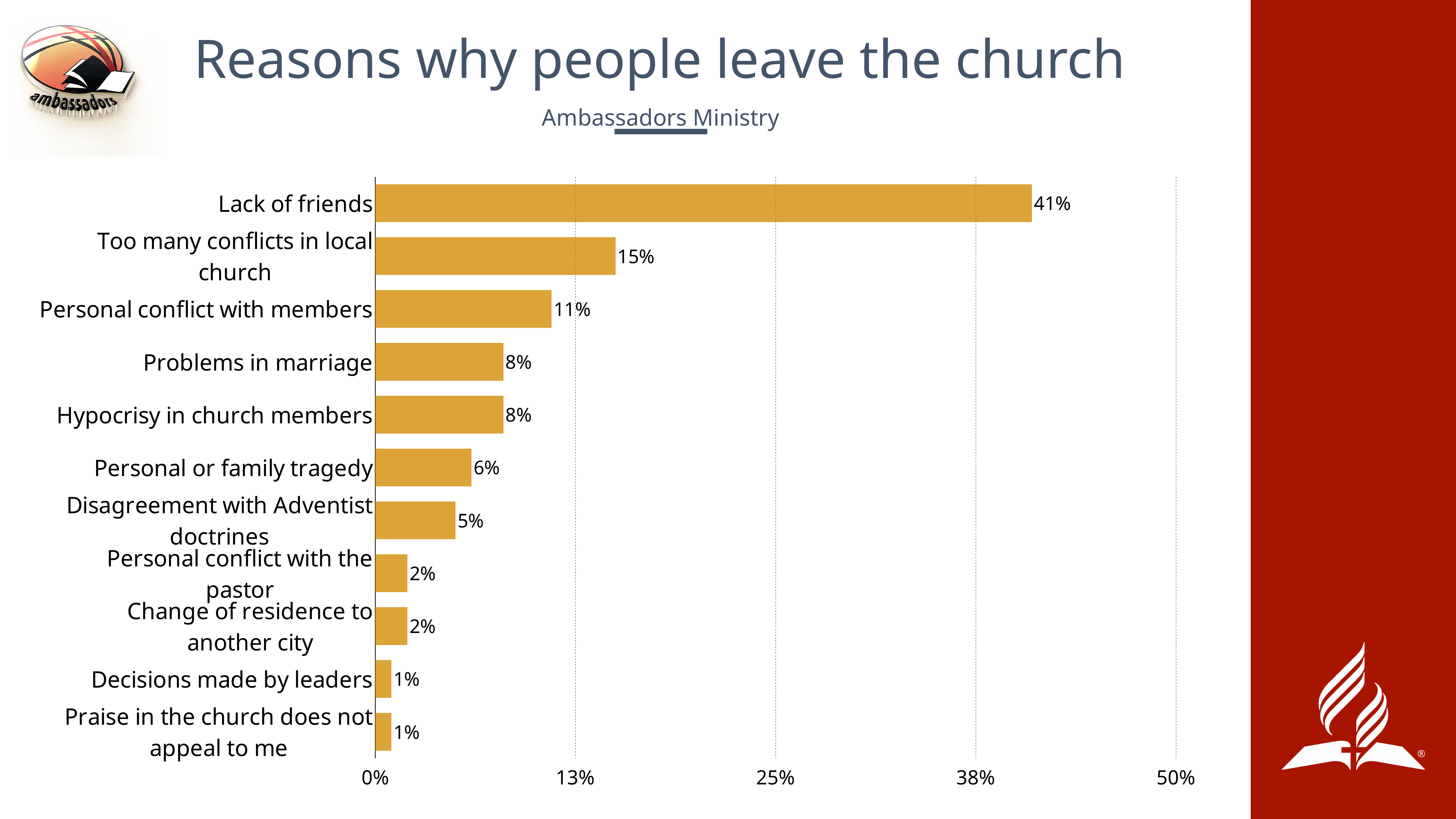
What percentage is given for "Personal or family tragedy"? 6% What percentage is shown for "Lack of friends"? 41% What is the value for "Disagreement with Adventist doctrines"? 5% What kind of chart is shown on the slide? Bar chart Which is larger: "Personal conflict with members" or "Personal or family tragedy"? Personal conflict with members What is the difference between "Personal conflict with members" and "Problems in marriage"? 3% What is the difference between the values for "Lack of friends" and "Too many conflicts in local church"? 26% Is the value for "Lack of friends" greater or less than 38%? greater How many reasons (categories) are plotted in the chart? 11 What is the value for "Too many conflicts in local church"? 15% What is the title of the slide containing the chart? Reasons why people leave the church Which reason has the highest percentage? Lack of friends